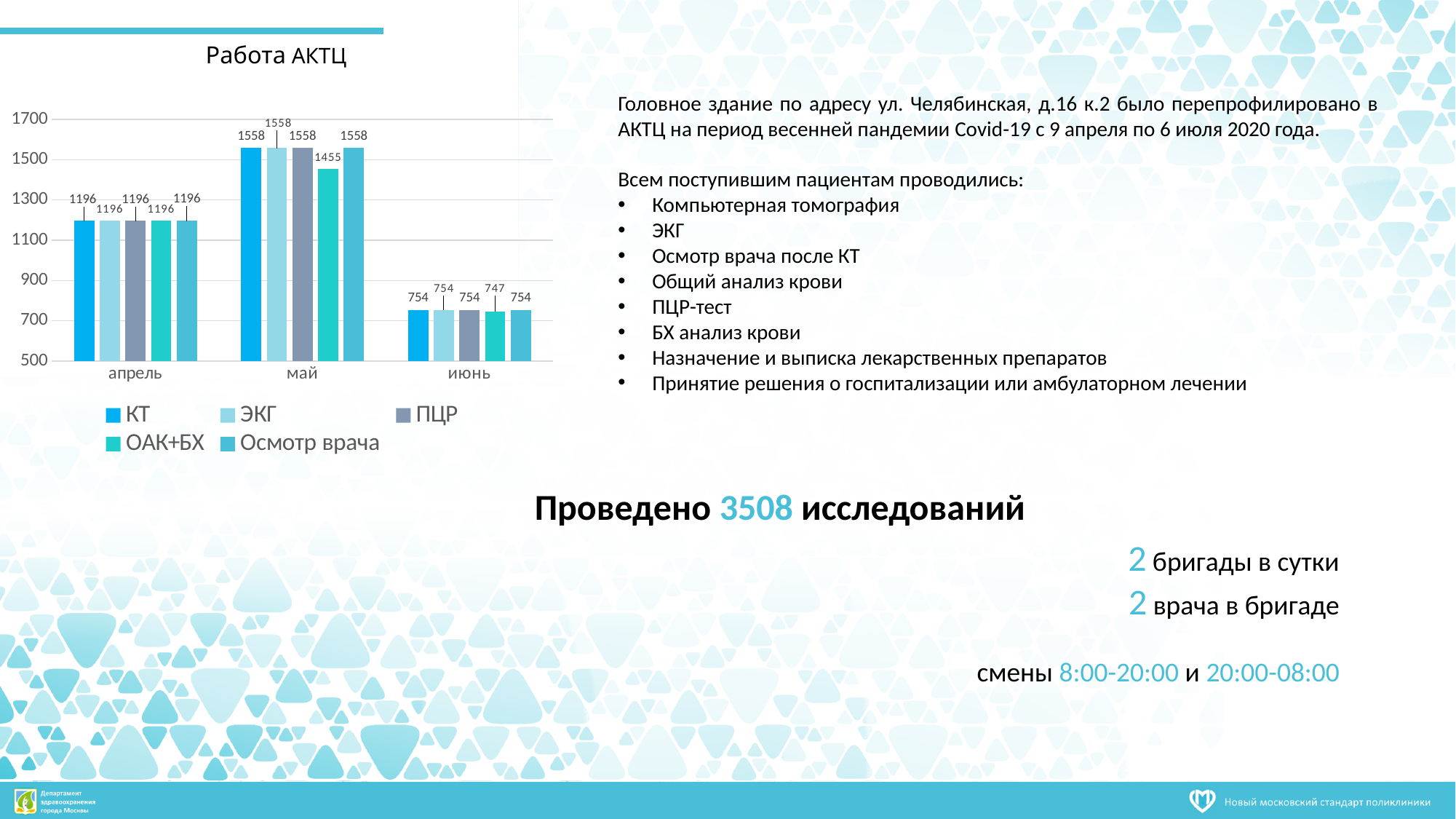
Which is larger in май: the value for ПЦР or the value for ОАК+БХ? ПЦР What is the value for ОАК+БХ in май? 1455 How many categories (months) are shown on the x axis of the chart? 3 What type of chart is shown on the slide? bar chart What is the value for ЭКГ in апрель? 1196 What is the value for КТ in май? 1558 In which month is the value for Осмотр врача the lowest? июнь What is the title of the chart? Работа АКТЦ In which month is the value for КТ the highest? май What is the value for ОАК+БХ in июнь? 747 How many series does the chart legend list? 5 What is the difference between the КТ value in май and the КТ value in июнь? 804